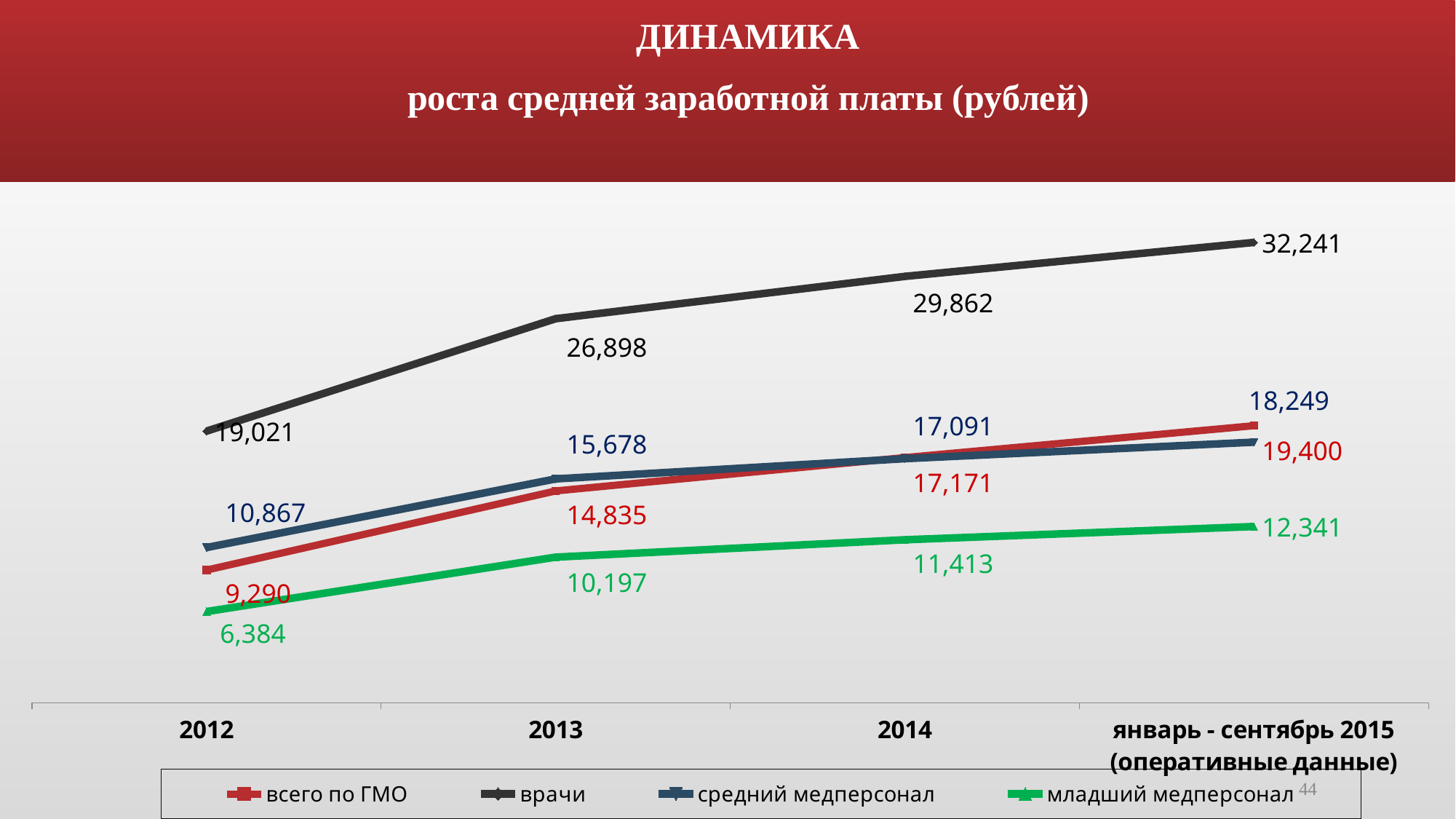
Which series has the lowest value in 2013? младший медперсонал What type of chart is shown on the slide? line chart What is the value for врачи in 2013? 26,898 Do the values for младший медперсонал rise or fall from 2012 to январь - сентябрь 2015? rise What is the value for всего по ГМО in январь - сентябрь 2015? 19,400 Which is larger in 2013: the value for средний медперсонал or the value for всего по ГМО? средний медперсонал What is the value for младший медперсонал in 2012? 6,384 How many points along the x axis does each line have? 4 What is the value for средний медперсонал in 2014? 17,091 What is the difference between the врачи values in январь - сентябрь 2015 and 2012? 13,220 Which series has the highest value in 2014? врачи How many series does the legend list? 4